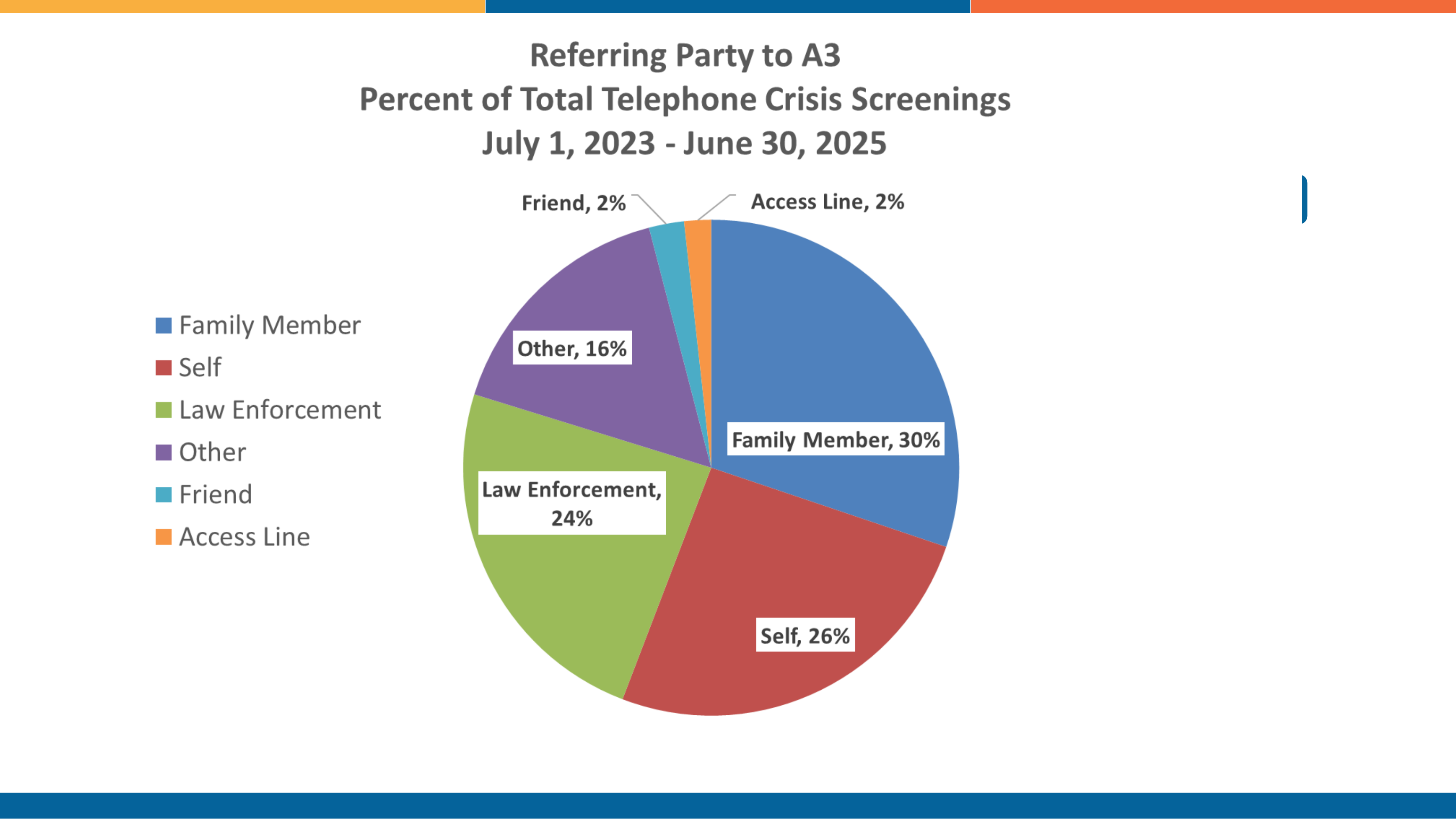
How many referring party categories are shown in the pie chart? 6 What colour represents Access Line in the pie chart? Orange What percentage of telephone crisis screenings were referred by a Family Member? 30% What percentage of telephone crisis screenings were referred by a Friend? 2% What percentage of telephone crisis screenings were Self referrals? 26% What type of chart is shown on the slide? Pie chart What percentage of telephone crisis screenings were referred by Law Enforcement? 24% Which is larger, the share for Law Enforcement or the share for Other? Law Enforcement Which referring party accounts for the largest share of telephone crisis screenings? Family Member What date range does the chart title cover? July 1, 2023 - June 30, 2025 What is the difference in percentage points between Family Member and Self referrals? 4 What percentage of telephone crisis screenings fall under the Other referring party? 16%